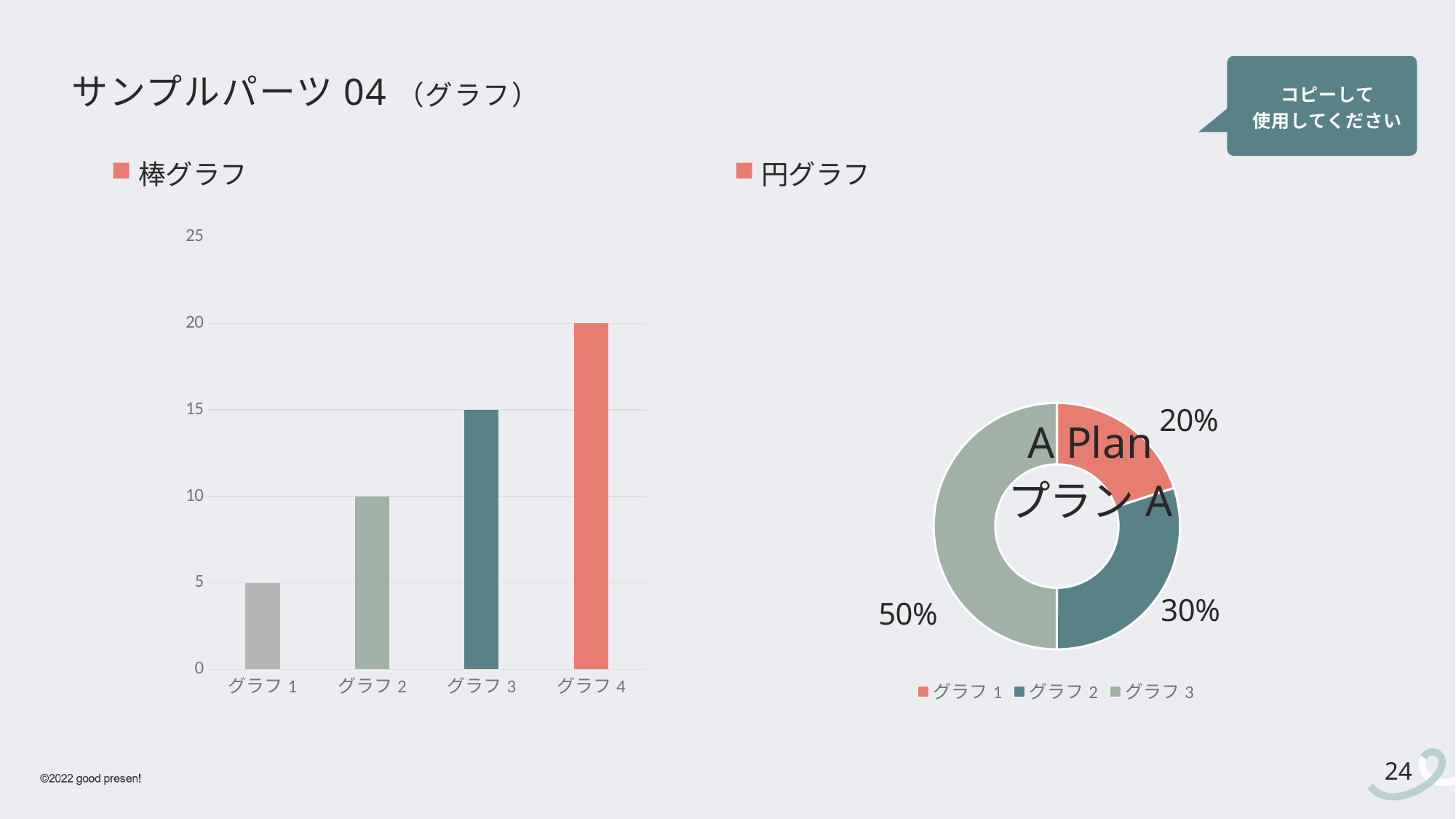
In the bar chart (棒グラフ), what is the value for グラフ 4? 20 In the bar chart (棒グラフ), do the values rise or fall from グラフ 1 to グラフ 4? rise In the bar chart (棒グラフ), which category has the lowest value? グラフ 1 What kind of chart is the chart on the left of the slide? bar chart In the bar chart (棒グラフ), which category has the highest value? グラフ 4 In the pie chart (円グラフ), what share does グラフ 1 have? 20% In the pie chart (円グラフ), which slice is larger, グラフ 2 or グラフ 1? グラフ 2 In the bar chart (棒グラフ), what is the value for グラフ 1? 5 In the pie chart (円グラフ), what share does グラフ 3 have? 50% In the bar chart (棒グラフ), what is the difference between the values for グラフ 3 and グラフ 2? 5 In the bar chart (棒グラフ), how many categories are shown on the x axis? 4 In the pie chart (円グラフ), how many entries does the legend list? 3